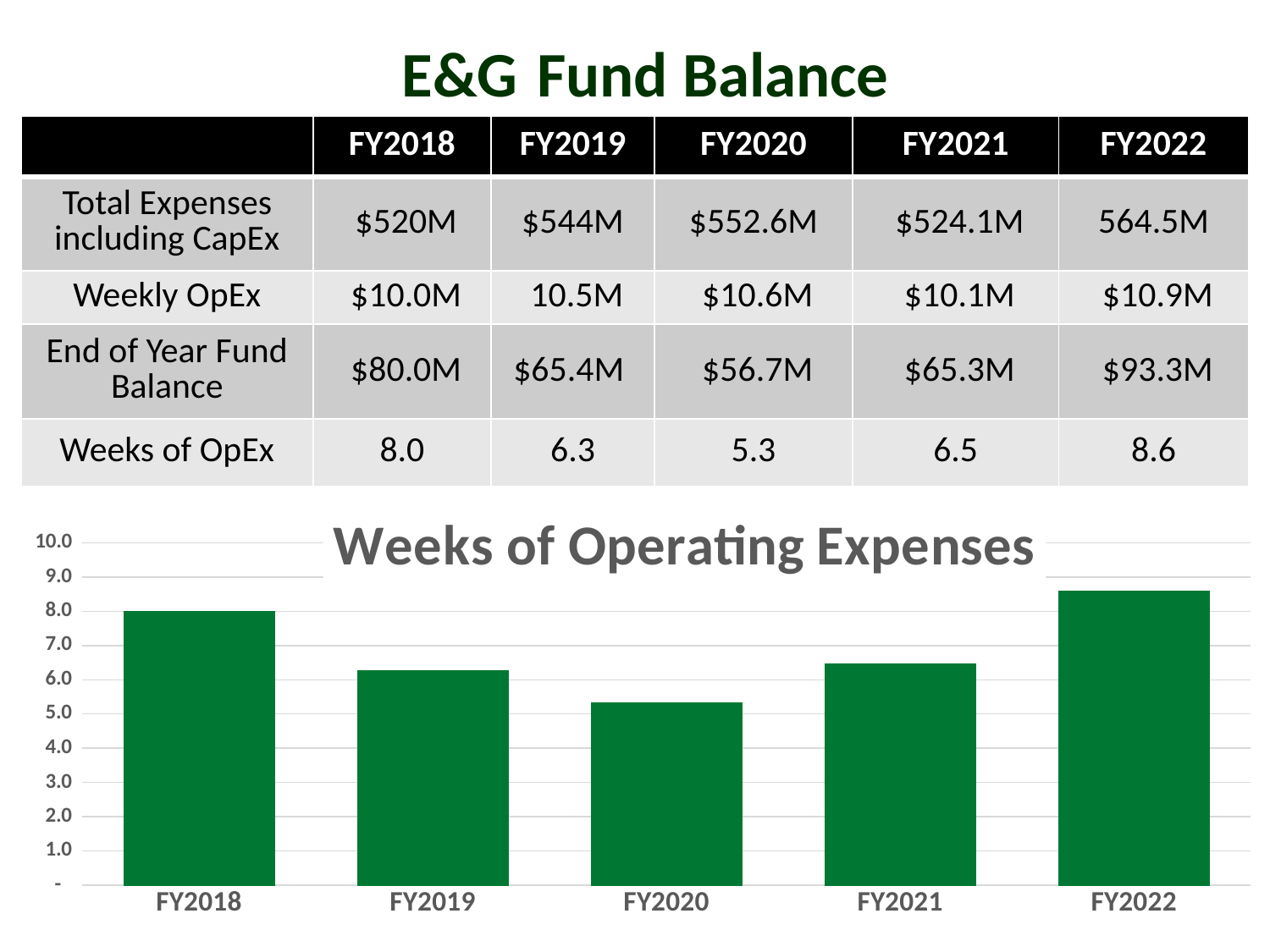
In the Weeks of Operating Expenses chart, what is the value for FY2022? 8.6 How many fiscal years are shown on the x axis of the Weeks of Operating Expenses chart? 5 Is the value for FY2019 in the Weeks of Operating Expenses chart greater or less than 7.0? less Which fiscal year has the highest value in the Weeks of Operating Expenses chart? FY2022 Is the value for FY2021 in the Weeks of Operating Expenses chart greater or less than 6.0? greater In the Weeks of Operating Expenses chart, what is the value for FY2018? 8.0 What is the title of the bar chart on the slide? Weeks of Operating Expenses Which fiscal year has the lowest value in the Weeks of Operating Expenses chart? FY2020 In the Weeks of Operating Expenses chart, which is larger, FY2019 or FY2021? FY2021 What is the difference between the FY2022 and FY2020 values in the Weeks of Operating Expenses chart? 3.3 What kind of chart is the Weeks of Operating Expenses chart? bar chart In the Weeks of Operating Expenses chart, what is the value for FY2020? 5.3